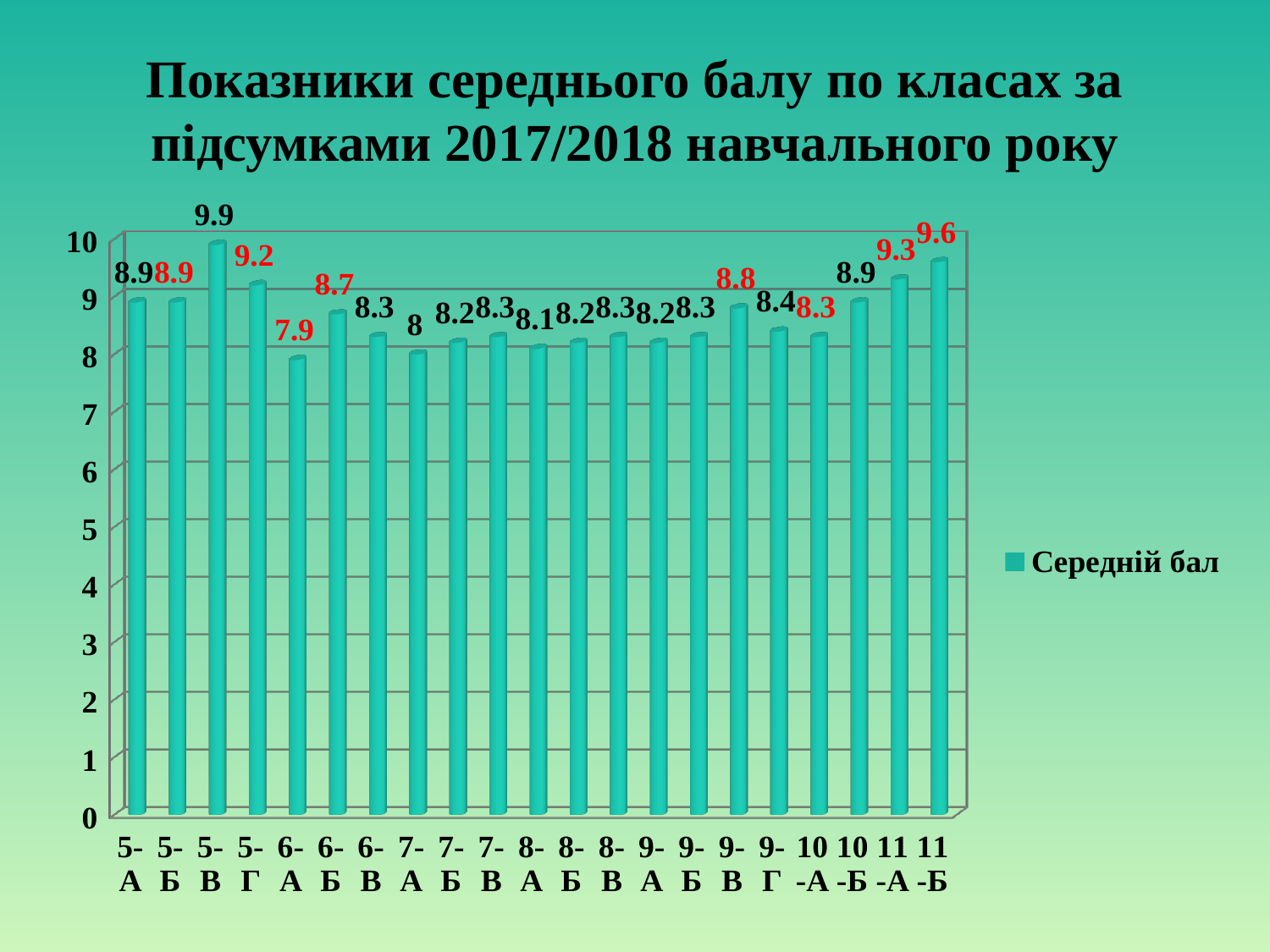
What is the average score for class 5-В? 9.9 What is the average score for class 6-А? 7.9 Which class has the lowest average score? 6-А What is the average score for class 9-В? 8.8 How many classes are shown on the chart? 21 What is the average score for class 11-Б? 9.6 Which class has a higher average score, 11-А or 10-Б? 11-А How many series does the legend list? 1 Which class has the highest average score? 5-В What is the difference between the average scores of 5-В and 6-А? 2 What is the name of the series in the legend? Середній бал What kind of chart is shown on the slide? Bar chart